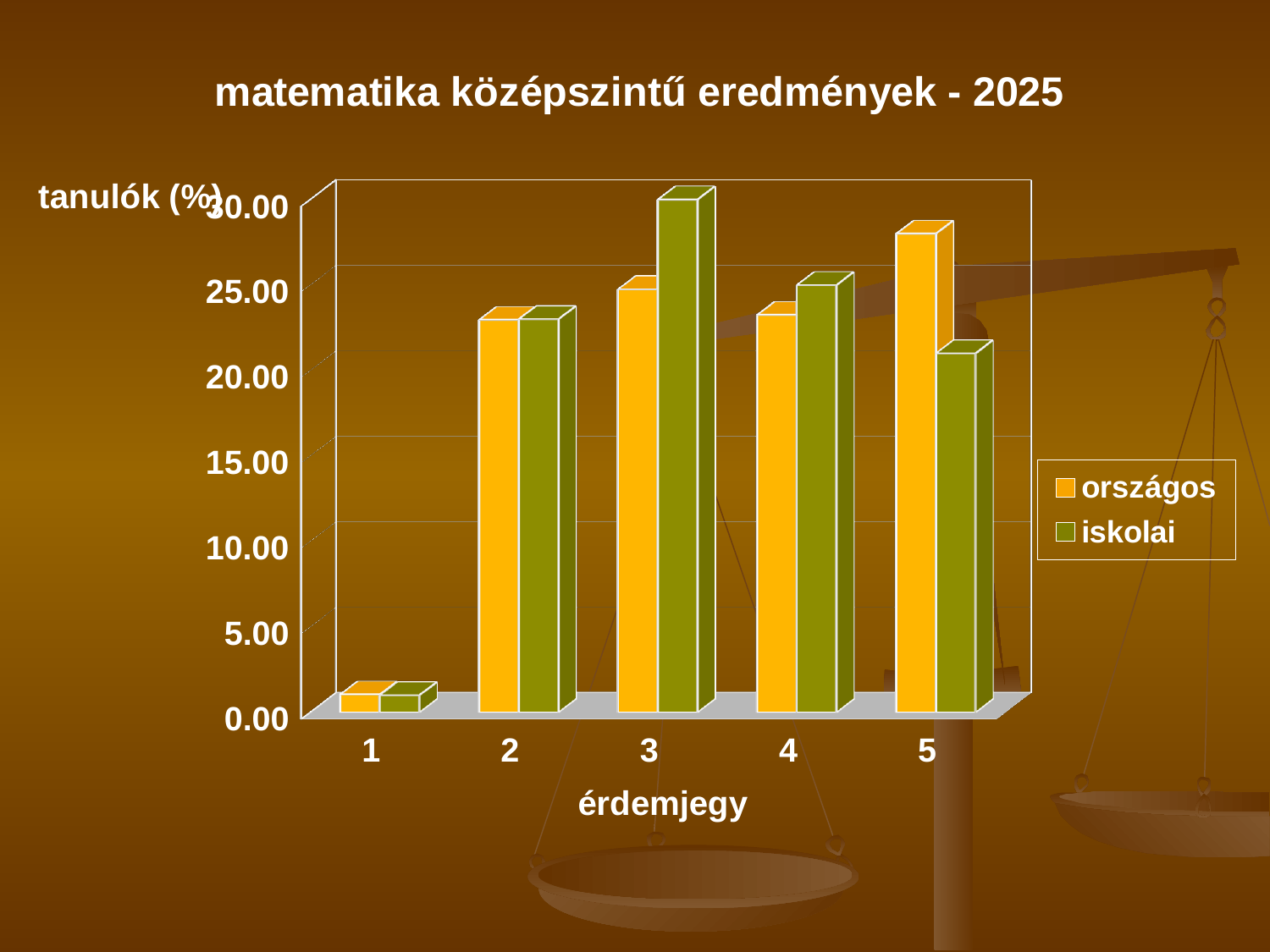
Is the iskolai value for érdemjegy 1 greater or less than 5.00? less What are the two series named in the legend? országos, iskolai For which érdemjegy is the iskolai value highest? 3 For which érdemjegy is the országos value highest? 5 For érdemjegy 5, which series has the larger value, országos or iskolai? országos What kind of chart is shown on the slide? bar chart Is the iskolai value for érdemjegy 5 greater or less than 25.00? less How many érdemjegy categories are shown on the x axis? 5 Is the országos value for érdemjegy 5 greater or less than 25.00? greater For which érdemjegy is the országos value lowest? 1 What is the title of the chart? matematika középszintű eredmények - 2025 How many series does the legend list? 2